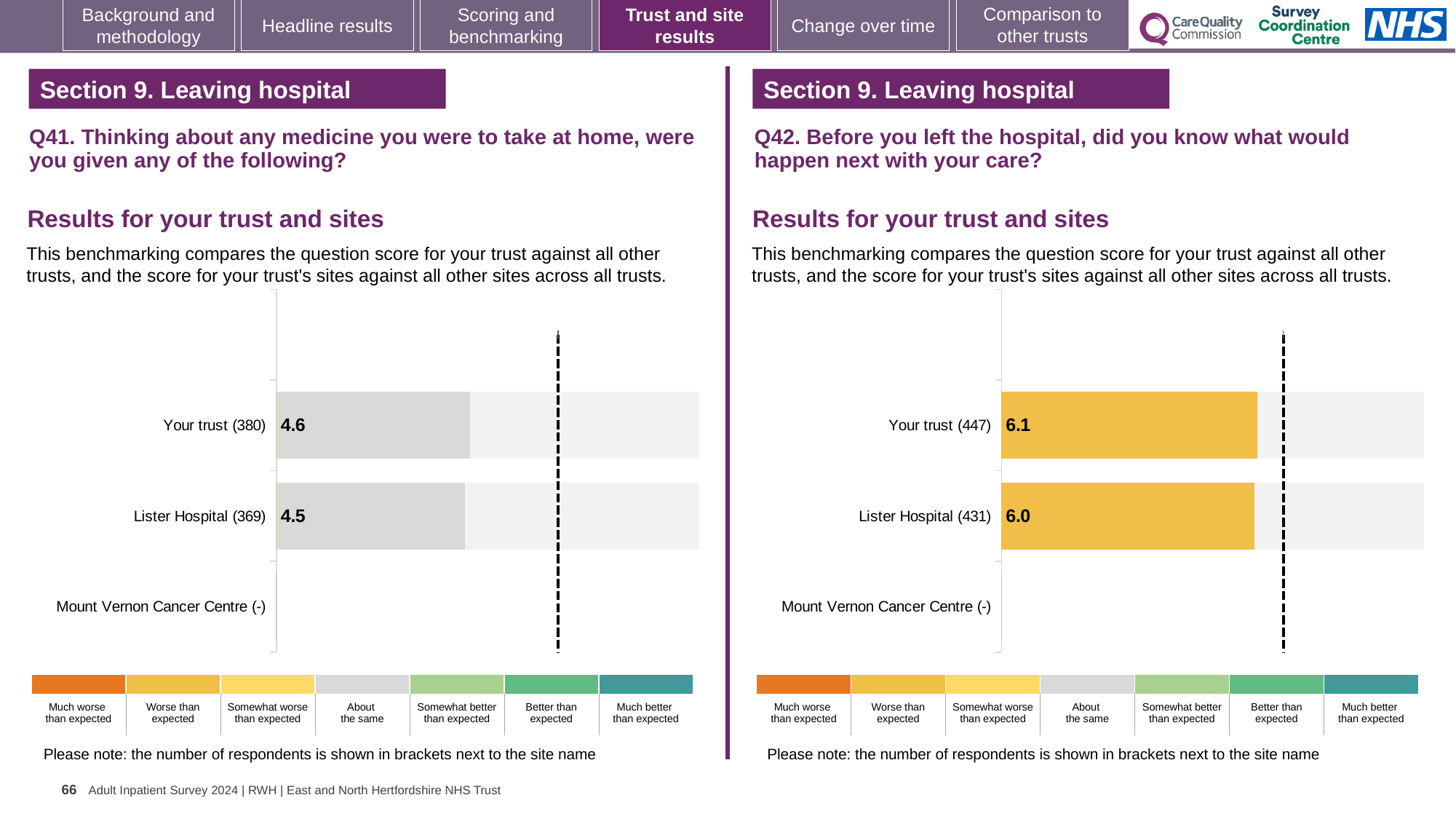
In the Q42 chart on the right, which benchmarking category does the colour of the Your trust bar correspond to? Worse than expected In the Q42 chart on the right, which has the higher score, Your trust or Lister Hospital? Your trust In the Q41 chart on the left, which benchmarking category does the colour of the Lister Hospital bar correspond to? About the same What kind of chart is the Q41 chart on the left? Bar chart How many categories (rows) are listed on the y axis of the Q42 chart on the right? 3 In the Q42 chart on the right, what is the score for Lister Hospital? 6.0 In the Q41 chart on the left, how many respondents are shown for Your trust? 380 In the Q41 chart on the left, what is the difference between the scores for Your trust and Lister Hospital? 0.1 In the Q42 chart on the right, how many respondents are shown for Lister Hospital? 431 In the Q42 chart on the right, what is the score for Your trust? 6.1 In the Q41 chart on the left, what is the score for Your trust? 4.6 In the Q41 chart on the left, what is the score for Lister Hospital? 4.5